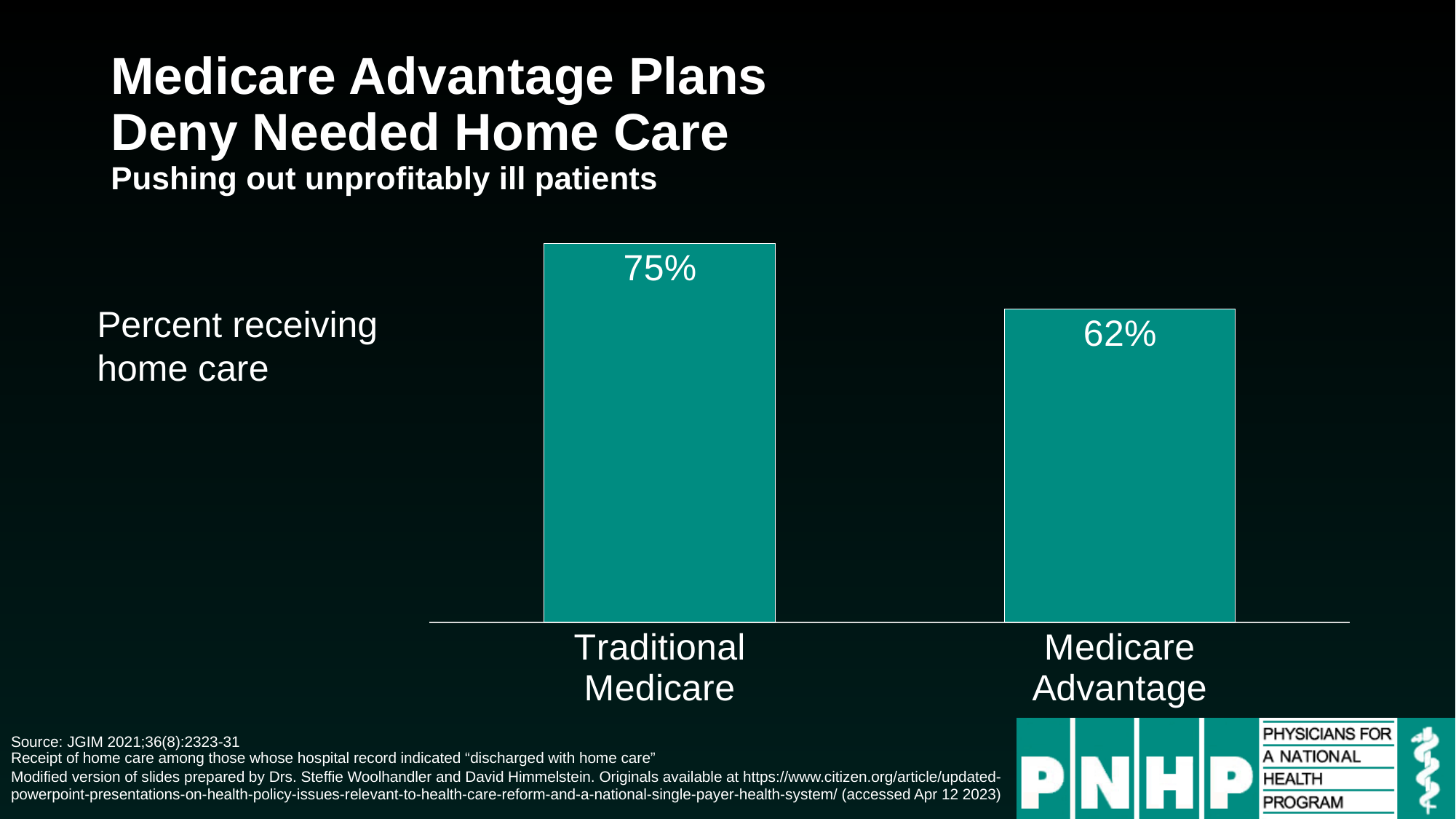
Is the percent receiving home care larger for Traditional Medicare or Medicare Advantage? Traditional Medicare Which category has the higher percent receiving home care? Traditional Medicare What percent of Traditional Medicare patients received home care? 75% What is the difference in percentage points between Traditional Medicare and Medicare Advantage in percent receiving home care? 13 What percent of Medicare Advantage patients received home care? 62% Which category has the lower percent receiving home care? Medicare Advantage Do the values rise or fall from Traditional Medicare to Medicare Advantage? Fall What kind of chart is shown on the slide? Bar chart How many categories are shown in the chart? 2 What colour are the bars in the chart? Teal What quantity does the chart measure, according to the label to the left of the bars? Percent receiving home care